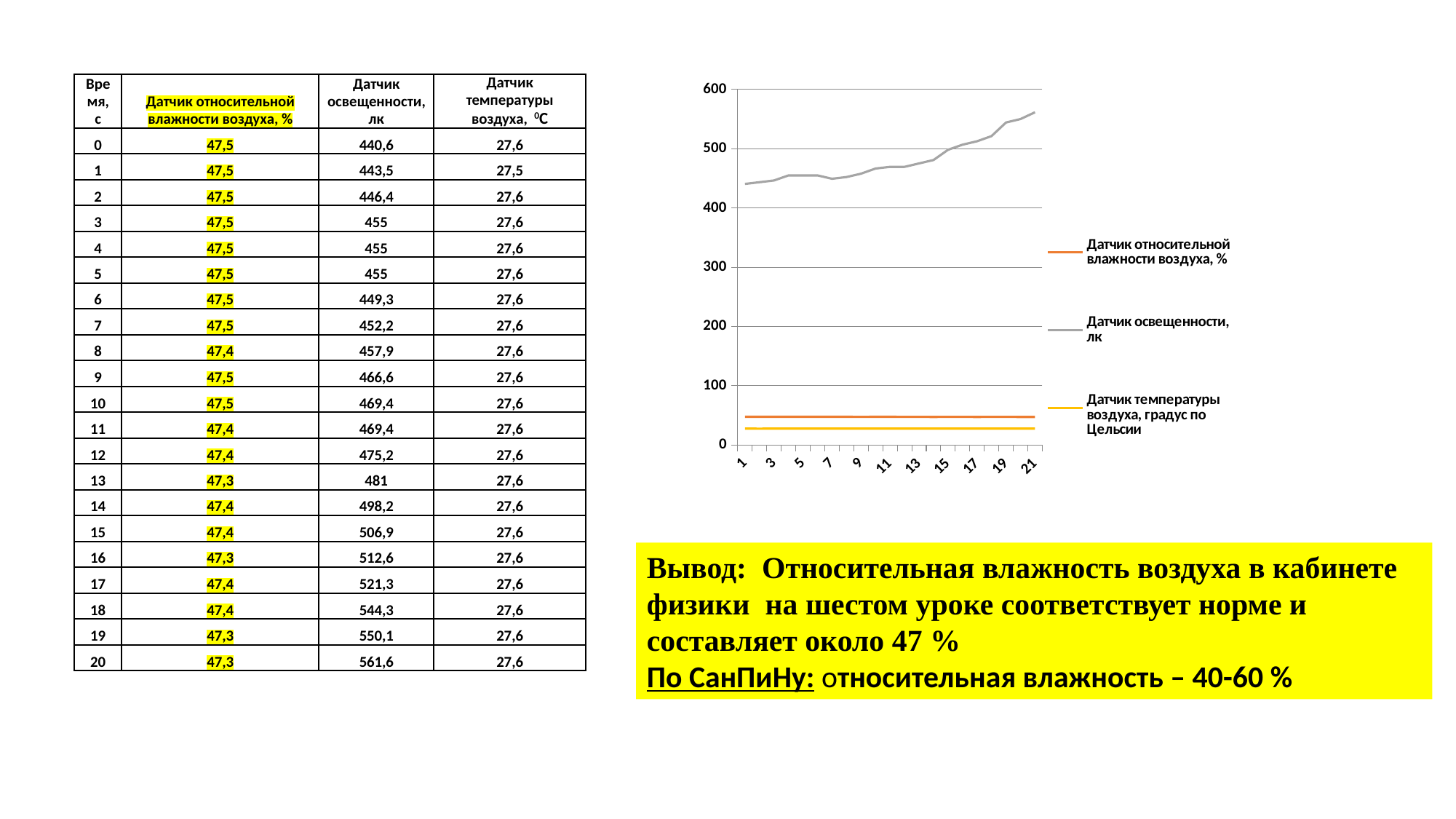
Does the line for Датчик освещенности, лк rise or fall along the x axis? rise Which series has the highest values on the chart? Датчик освещенности, лк What is the highest value shown on the chart's y axis? 600 What kind of chart is shown on the slide? line chart Which series has the lowest values on the chart? Датчик температуры воздуха, градус по Цельсии Is the value of the Датчик освещенности, лк line at x = 21 greater or less than 500? greater Which line is higher on the chart: Датчик относительной влажности воздуха, % or Датчик температуры воздуха, градус по Цельсии? Датчик относительной влажности воздуха, % Is the value of the Датчик освещенности, лк line at x = 1 greater or less than 400? greater How many series does the chart legend list? 3 What is the last label on the chart's x axis? 21 What colour is the line for Датчик освещенности, лк? grey Is the Датчик относительной влажности воздуха, % line greater or less than 100 across the chart? less